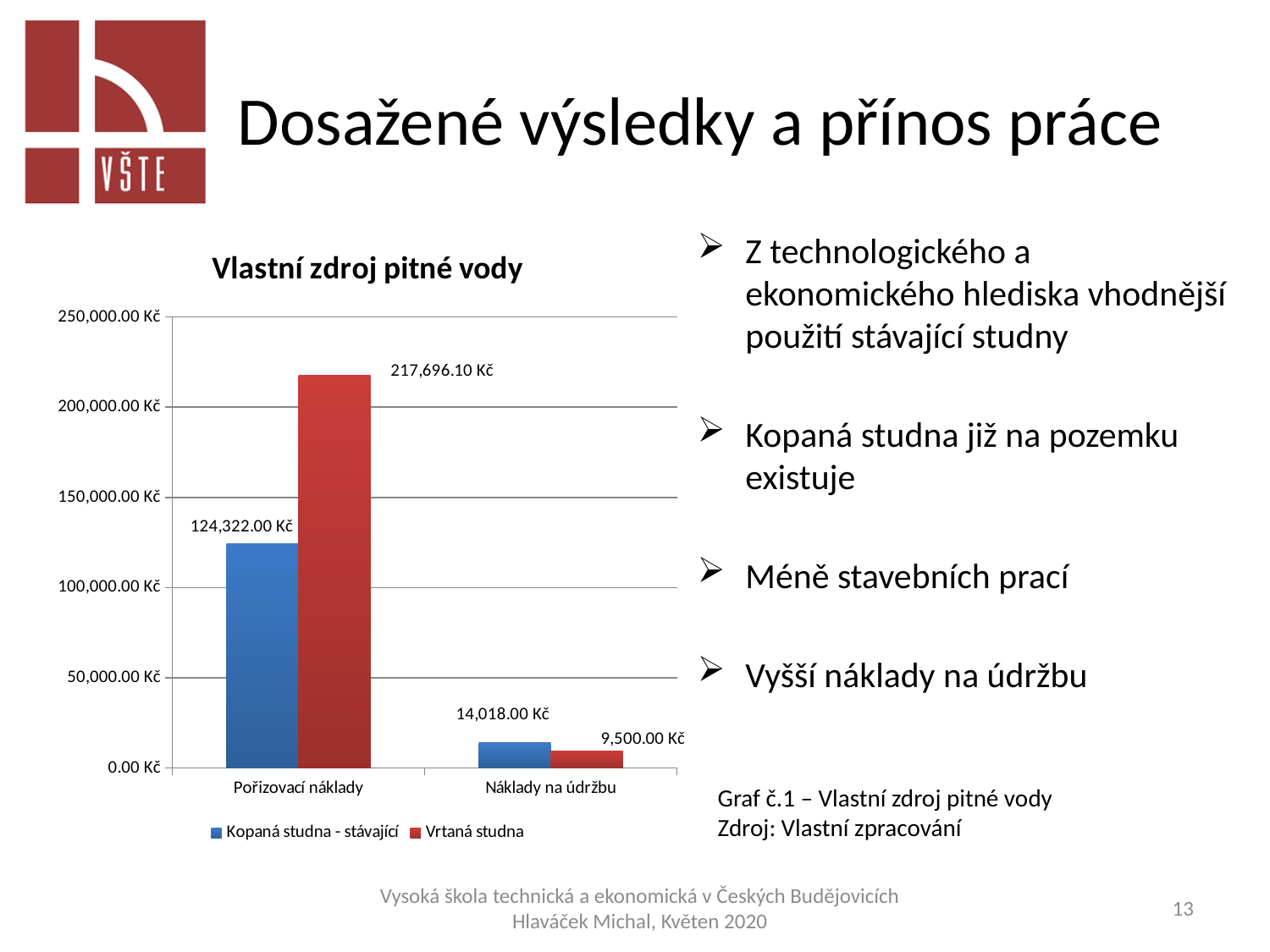
Which series has the higher value in the Pořizovací náklady category? Vrtaná studna Which series has the lower value in the Náklady na údržbu category? Vrtaná studna What is the difference between the Vrtaná studna and Kopaná studna - stávající values for Pořizovací náklady? 93,374.10 Kč What is the value for Kopaná studna - stávající in the Náklady na údržbu category? 14,018.00 Kč What is the difference between the Kopaná studna - stávající and Vrtaná studna values for Náklady na údržbu? 4,518.00 Kč What is the value for Vrtaná studna in the Náklady na údržbu category? 9,500.00 Kč What type of chart is shown on the slide? bar chart What is the title of the chart? Vlastní zdroj pitné vody What is the value for Vrtaná studna in the Pořizovací náklady category? 217,696.10 Kč What is the value for Kopaná studna - stávající in the Pořizovací náklady category? 124,322.00 Kč How many series does the chart legend list? 2 How many categories are shown on the x axis of the chart? 2